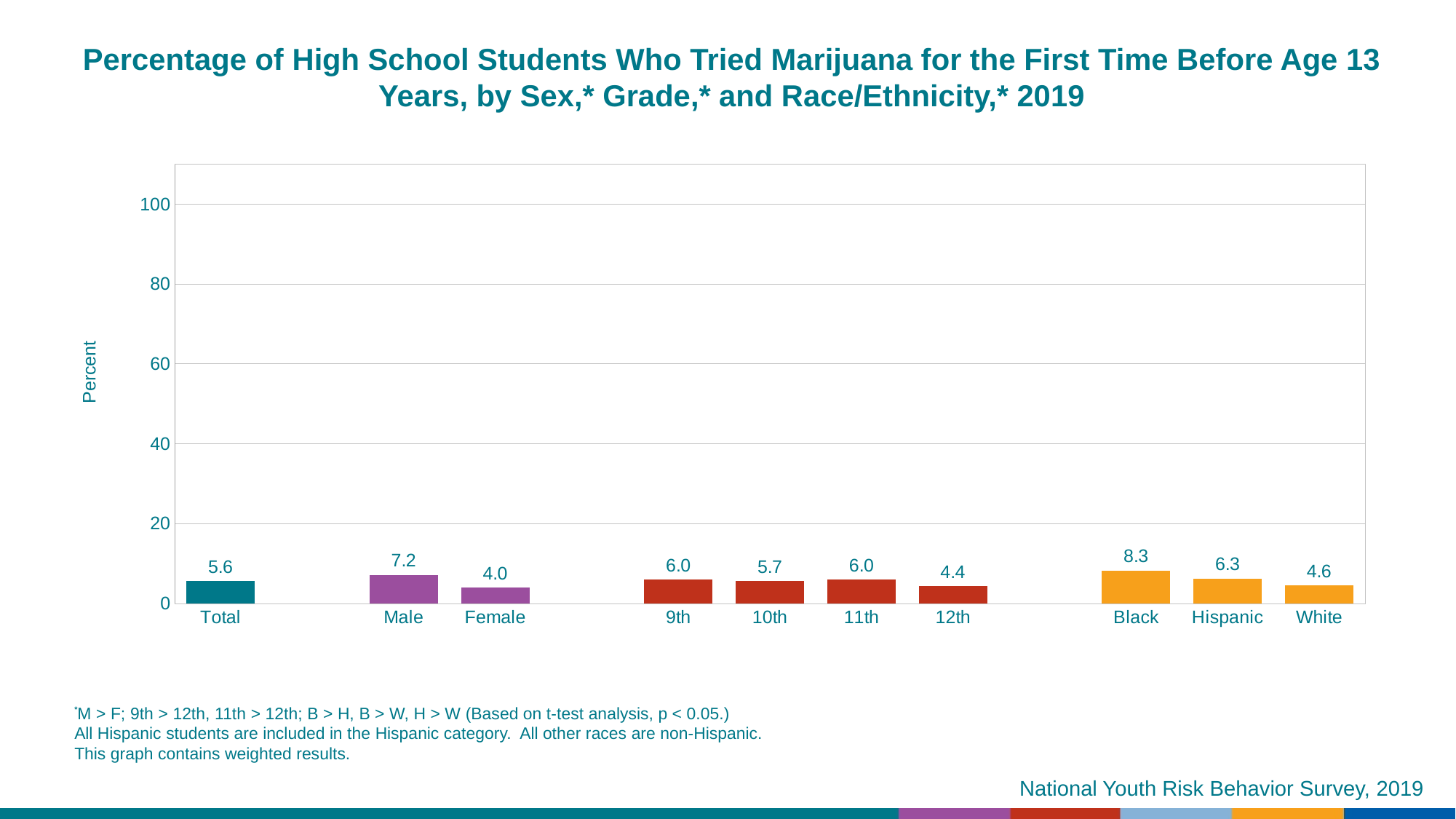
Is the value for Total greater or less than 20? less What is the value for 12th grade? 4.4 Which is larger, the value for Hispanic or the value for White? Hispanic What is the value for Male? 7.2 Which category has the lowest value? Female Which category has the highest value? Black What is the label on the y axis? Percent Do the values rise or fall from 11th grade to 12th grade? fall What is the difference between the values for Male and Female? 3.2 What is the value for Black? 8.3 How many categories are shown on the x axis? 10 What kind of chart is this? bar chart